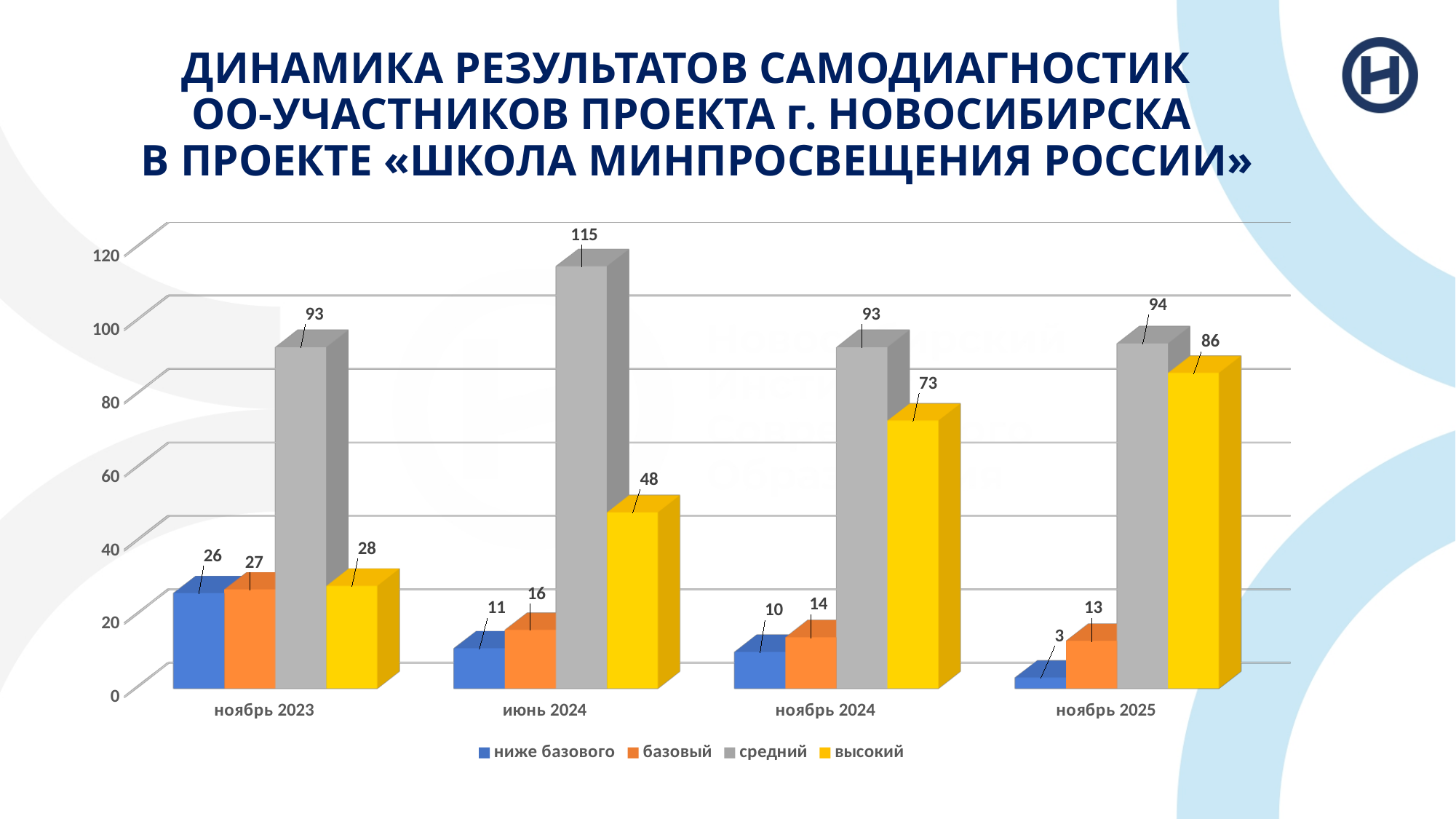
What is the value for «высокий» in ноябрь 2025? 86 Which is larger in ноябрь 2024: «средний» or «высокий»? средний Which period has the highest value for «средний»? июнь 2024 How many periods are shown on the x axis? 4 Which period has the lowest value for «ниже базового»? ноябрь 2025 What is the difference between the «высокий» values for ноябрь 2025 and ноябрь 2023? 58 What kind of chart is shown on the slide? bar chart What is the value for «средний» in ноябрь 2023? 93 What is the value for «ниже базового» in июнь 2024? 11 How many series does the legend list? 4 Does the value for «высокий» rise or fall from ноябрь 2023 to ноябрь 2025? rise Is the value for «высокий» in июнь 2024 greater or less than 40? greater